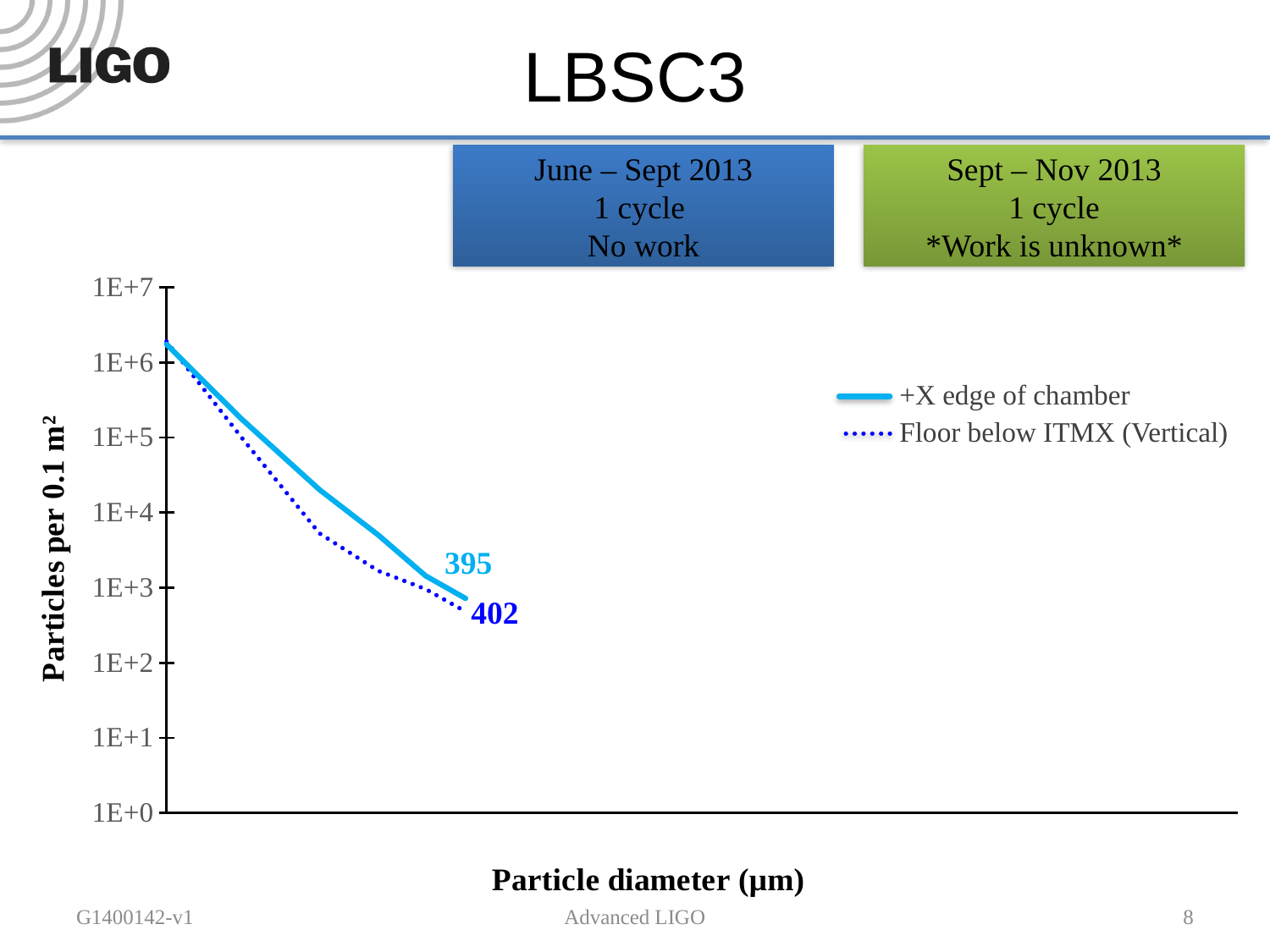
What data label is printed at the end of the +X edge of chamber series? 395 What data label is printed at the end of the Floor below ITMX (Vertical) series? 402 What is the title of the x axis? Particle diameter (µm) What is the difference between the printed data labels 402 and 395? 7 What is the title of the y axis? Particles per 0.1 m² Which series has the larger printed data label, +X edge of chamber or Floor below ITMX (Vertical)? Floor below ITMX (Vertical) Do the values of the +X edge of chamber series rise or fall as particle diameter increases along the x axis? fall Is the starting value of the +X edge of chamber series greater or less than 1E+5? greater How many series does the legend list? 2 Is the starting value of the Floor below ITMX (Vertical) series greater or less than 1E+6? greater What kind of chart is shown on the slide? line chart